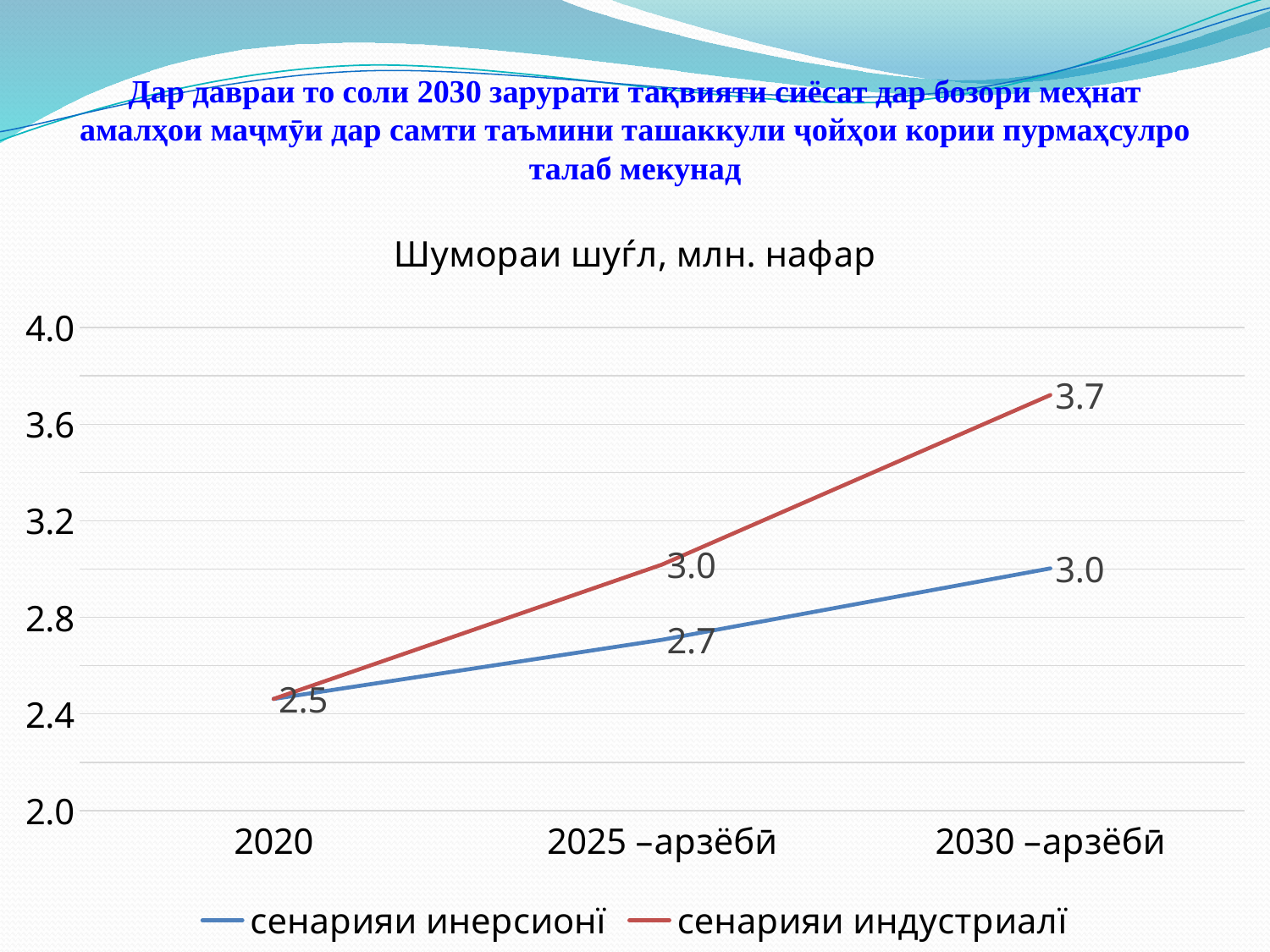
What is the title of the chart? Шумораи шуғл, млн. нафар What is the value for сенарияи индустриалӣ at 2030 –арзёбӣ? 3.7 How many series does the legend list? 2 Do the values for сенарияи индустриалӣ rise or fall from 2020 to 2030 –арзёбӣ? rise What is the value for сенарияи инерсионӣ at 2025 –арзёбӣ? 2.7 What value is labelled at 2020? 2.5 What kind of chart is shown on the slide? line chart Which series has the higher value at 2025 –арзёбӣ? сенарияи индустриалӣ How many points are plotted along the x axis for each series? 3 What is the value for сенарияи инерсионӣ at 2030 –арзёбӣ? 3.0 What is the difference between the two series at 2030 –арзёбӣ? 0.7 What is the value for сенарияи индустриалӣ at 2025 –арзёбӣ? 3.0